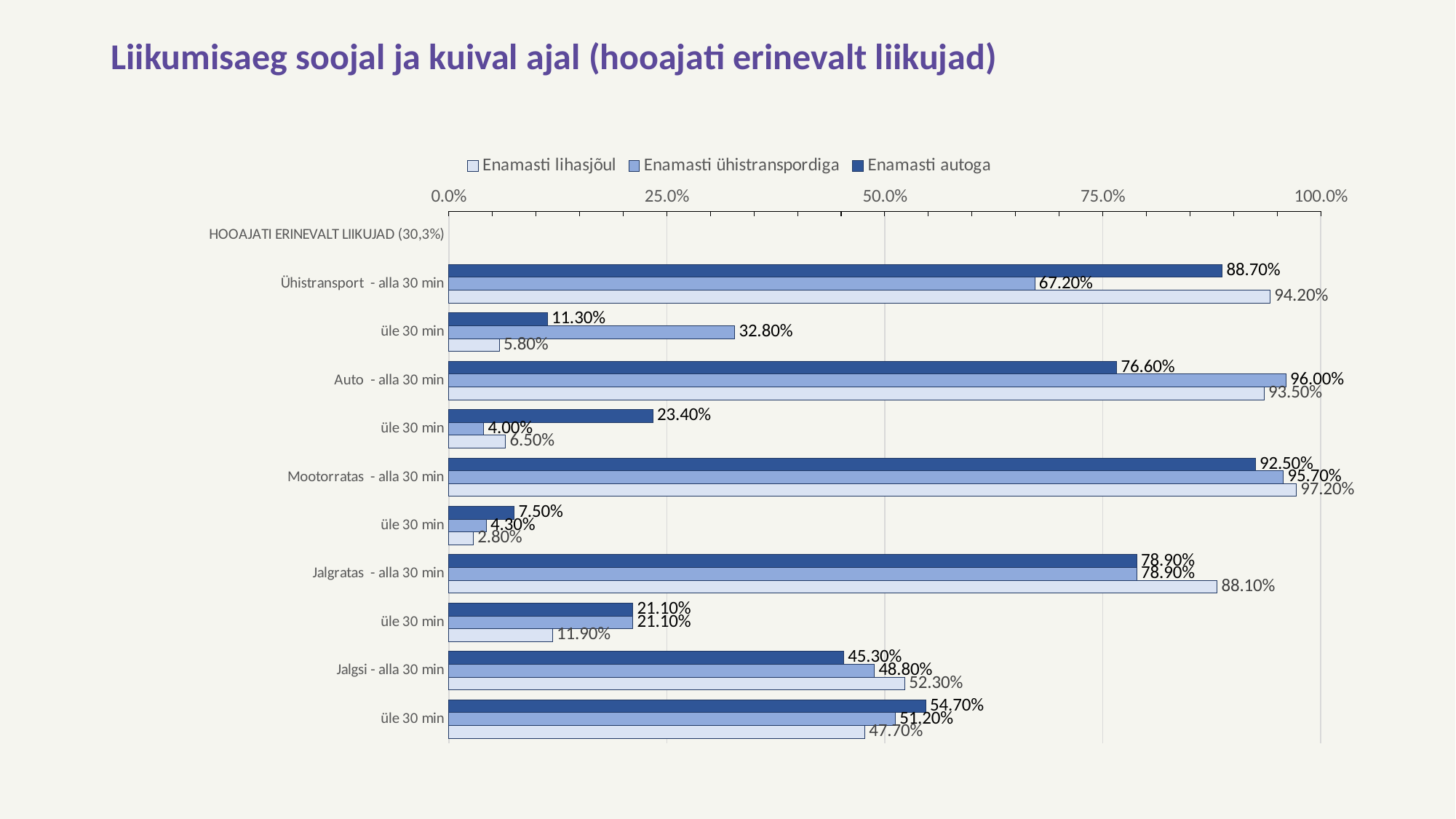
What is the value for 'Enamasti lihasjõul' in the 'Mootorratas - alla 30 min' category? 97.20% How many series does the legend list? 3 Which series is shown with the darkest blue bars? Enamasti autoga In the 'Jalgratas - alla 30 min' category, which is larger: 'Enamasti lihasjõul' or 'Enamasti autoga'? Enamasti lihasjõul Which series has the lowest value in the 'Auto - alla 30 min' category? Enamasti autoga What is the value for 'Enamasti ühistranspordiga' in the 'Auto - alla 30 min' category? 96.00% What is the value for 'Enamasti autoga' in the 'Ühistransport - alla 30 min' category? 88.70% What is the value for 'Enamasti lihasjõul' in the 'Jalgsi - alla 30 min' category? 52.30% Is the value for 'Enamasti autoga' in the 'Jalgsi - alla 30 min' category greater or less than 50.0%? less What type of chart is shown on the slide? bar chart Which series has the highest value in the 'Ühistransport - alla 30 min' category? Enamasti lihasjõul What is the difference between 'Enamasti ühistranspordiga' and 'Enamasti lihasjõul' in the 'Ühistransport - alla 30 min' category? 27.00%